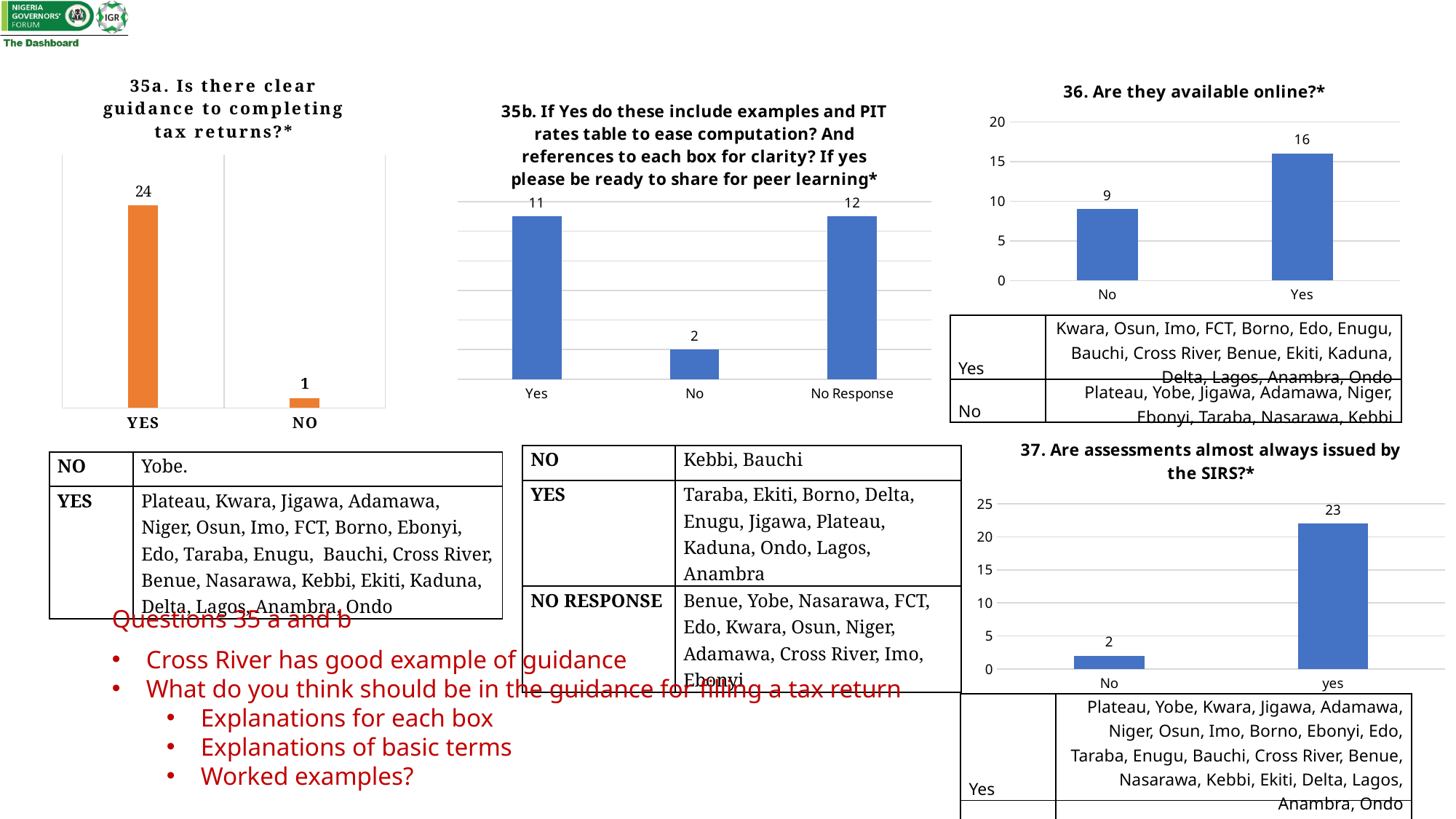
In the chart titled "36. Are they available online?*", is the value for Yes greater or less than 15? greater In the chart titled "35a. Is there clear guidance to completing tax returns?*", what is the value for NO? 1 In the chart titled "35b. If Yes do these include examples and PIT rates table to ease computation?...", how many categories are shown on the x axis? 3 In the chart titled "37. Are assessments almost always issued by the SIRS?*", which is larger, the value for No or the value for yes? yes In the chart titled "35b. If Yes do these include examples and PIT rates table to ease computation?...", what is the value for No Response? 12 In the chart titled "36. Are they available online?*", what is the difference between the Yes and No values? 7 In the chart titled "35b. If Yes do these include examples and PIT rates table to ease computation?...", which category has the lowest value? No In the chart titled "35a. Is there clear guidance to completing tax returns?*", what is the difference between the YES and NO values? 23 In the chart titled "35a. Is there clear guidance to completing tax returns?*", what is the value for YES? 24 In the chart titled "37. Are assessments almost always issued by the SIRS?*", what is the value for yes? 23 In the chart titled "36. Are they available online?*", what is the value for No? 9 What kind of chart is the chart titled "37. Are assessments almost always issued by the SIRS?*"? bar chart